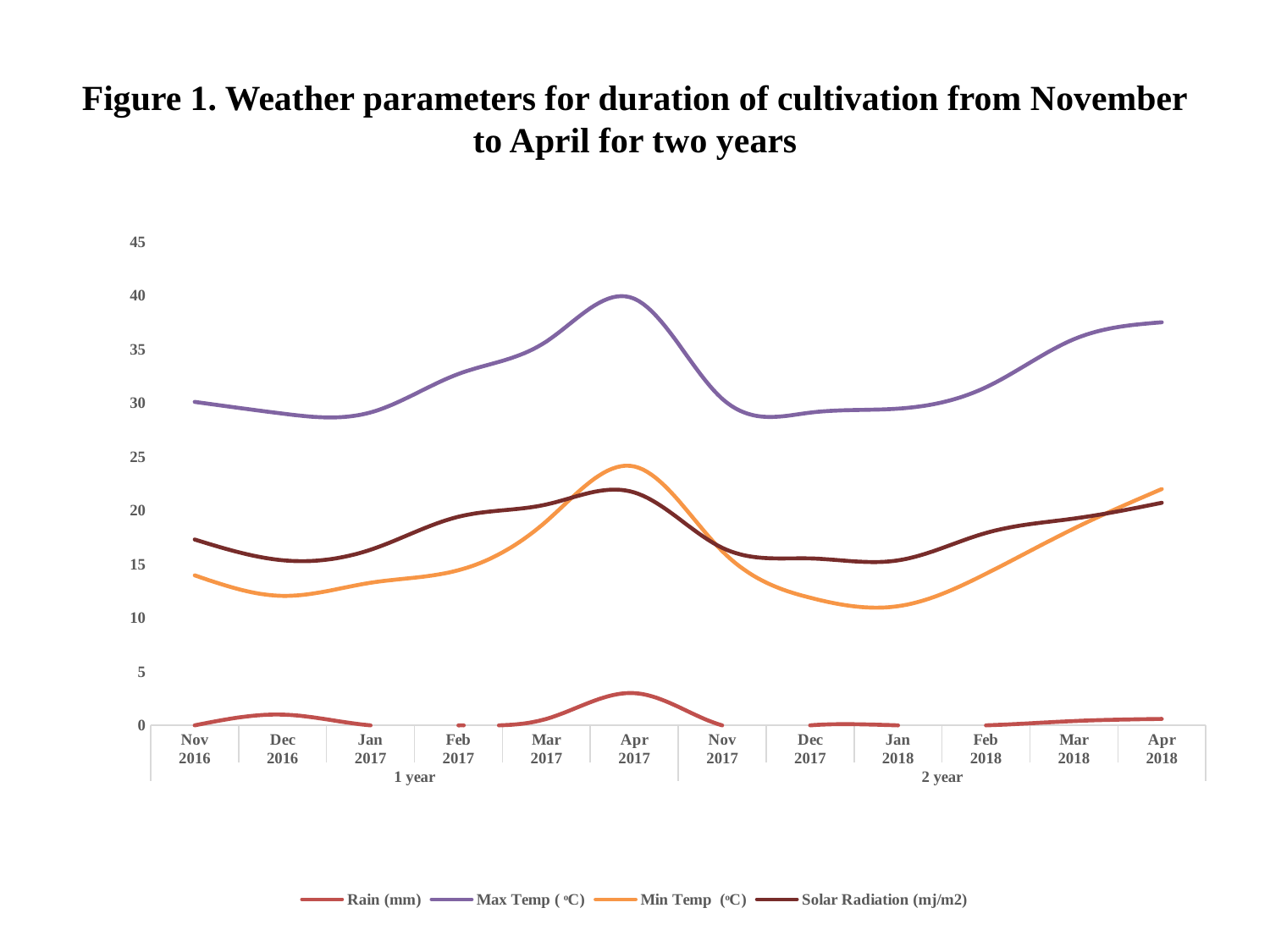
How many series does the legend list? 4 Is the Max Temp (°C) value for Apr 2018 greater or less than 35? greater In which month does the Max Temp (°C) series reach its highest value? Apr 2017 In which month is the Rain (mm) series highest? Apr 2017 Does the Max Temp (°C) series rise or fall from Nov 2017 to Apr 2018? rise What kind of chart is shown on the slide? line chart How many months are plotted along the x axis? 12 In which month does the Min Temp (°C) series reach its lowest value? Jan 2018 Is the Rain (mm) value for Apr 2017 greater or less than 5? less Is the Min Temp (°C) value for Jan 2018 greater or less than 15? less What are the two group labels shown beneath the month labels on the x axis? 1 year and 2 year In Nov 2016, which is higher: Solar Radiation (mj/m2) or Min Temp (°C)? Solar Radiation (mj/m2)